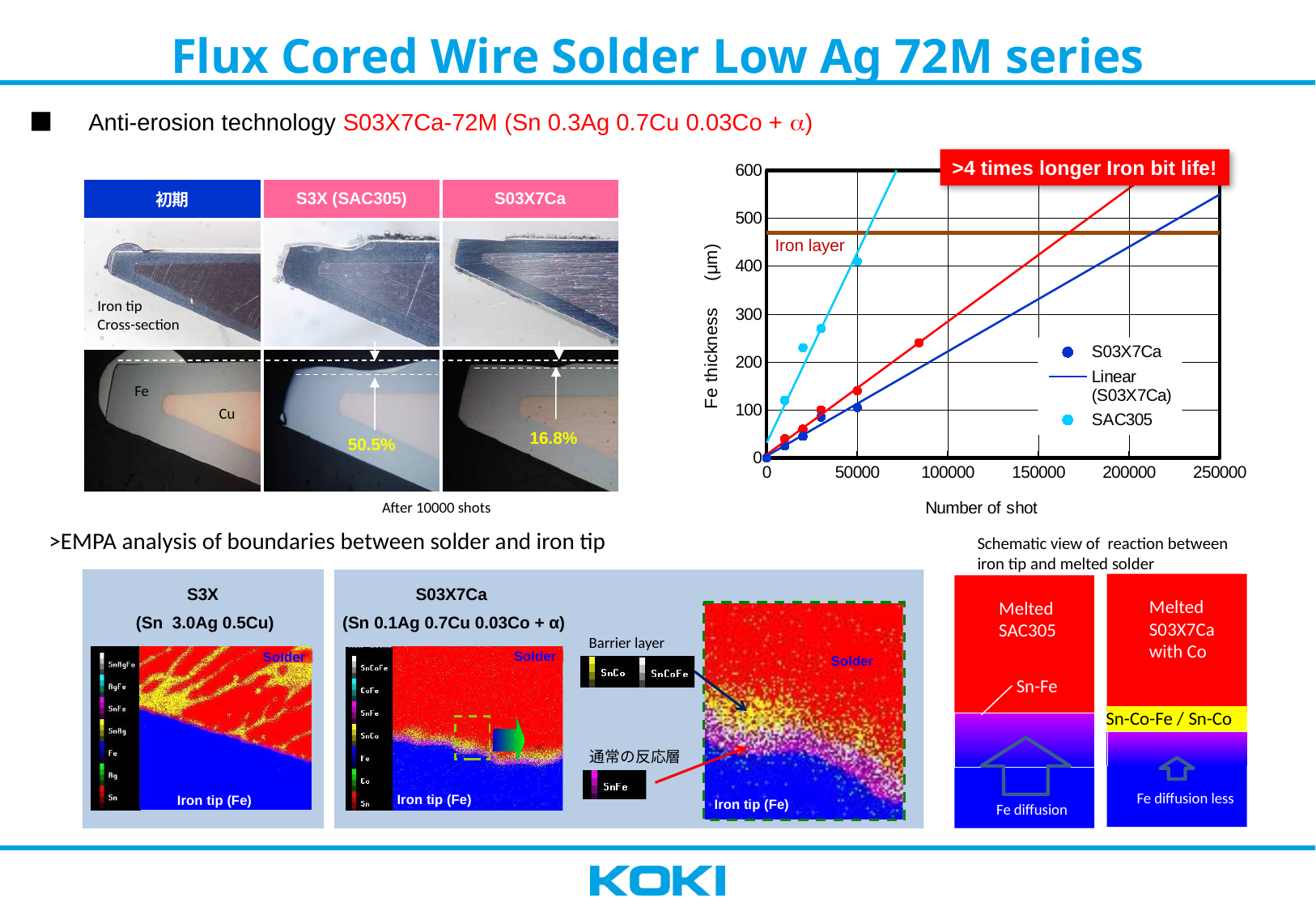
What kind of chart is shown on the slide? scatter chart Does the Fe thickness rise or fall as the number of shots increases? rises What is the highest tick value shown on the horizontal axis of the chart? 250000 At 50000 shots, which series has the higher Fe thickness, SAC305 or S03X7Ca? SAC305 What is the highest tick value shown on the vertical axis of the chart? 600 What is the label of the horizontal axis of the chart? Number of shot Is the Fe thickness for S03X7Ca at 50000 shots greater or less than 200? less Is the Fe thickness for SAC305 at 50000 shots greater or less than 300? greater What is the label of the vertical axis of the chart? Fe thickness (µm) Which series in the legend is drawn with light blue (cyan) markers? SAC305 How many entries does the chart legend list? 3 Is the horizontal 'Iron layer' line on the chart greater or less than 400 µm? greater